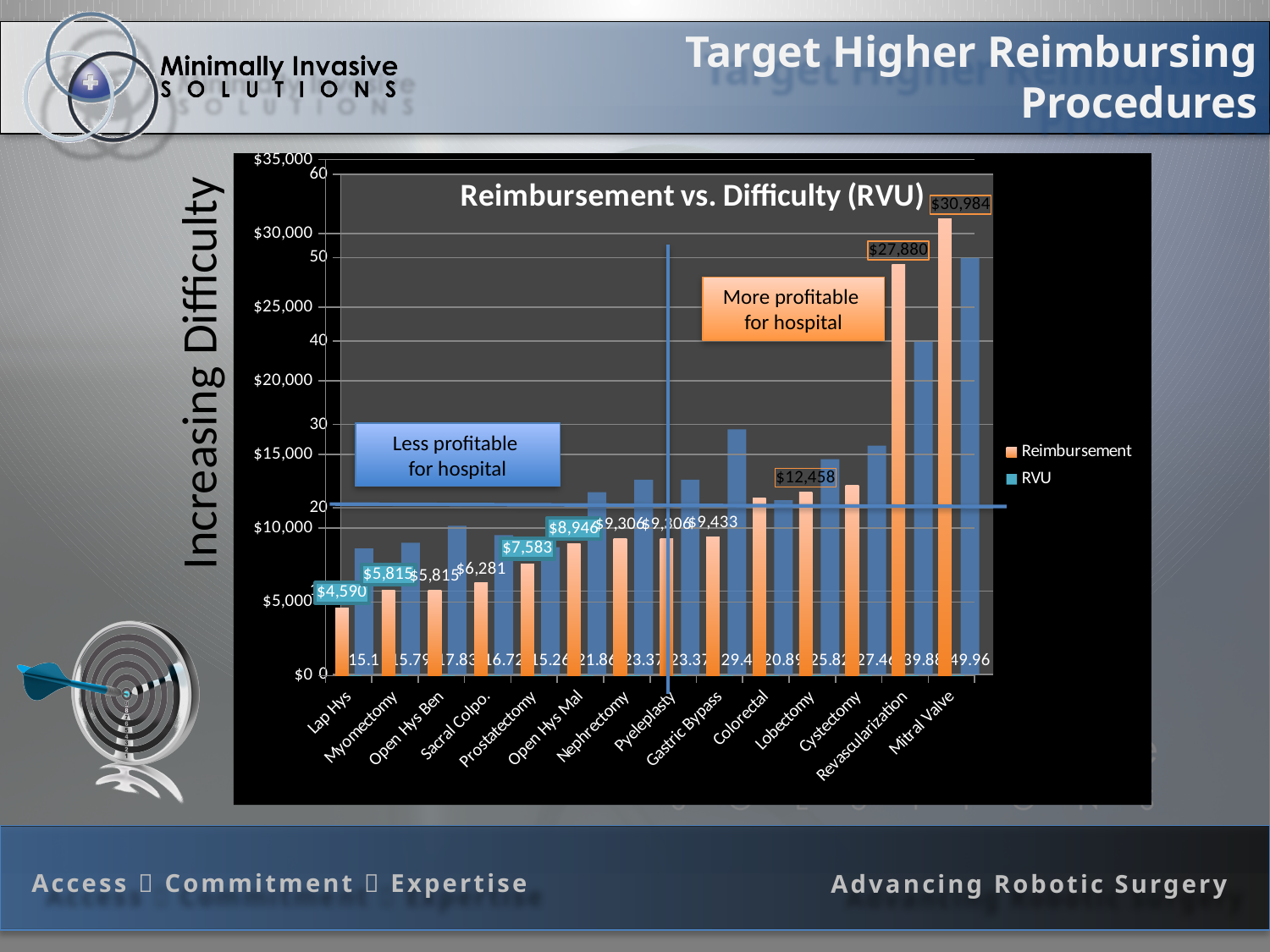
What is the Reimbursement value for Revascularization? $27,880 What is the RVU value for Revascularization? 39.88 What is the Reimbursement value for Mitral Valve? $30,984 Which procedure has the highest Reimbursement? Mitral Valve How many procedures are shown on the x axis? 14 What is the RVU value for Gastric Bypass? 29.4 What is the title of the chart? Reimbursement vs. Difficulty (RVU) What is the Reimbursement value for Lap Hys? $4,590 Which procedure has the lowest RVU? Lap Hys How many series does the legend list? 2 Which has the higher RVU, Colorectal or Lobectomy? Lobectomy What is the difference in Reimbursement between Mitral Valve and Revascularization? $3,104